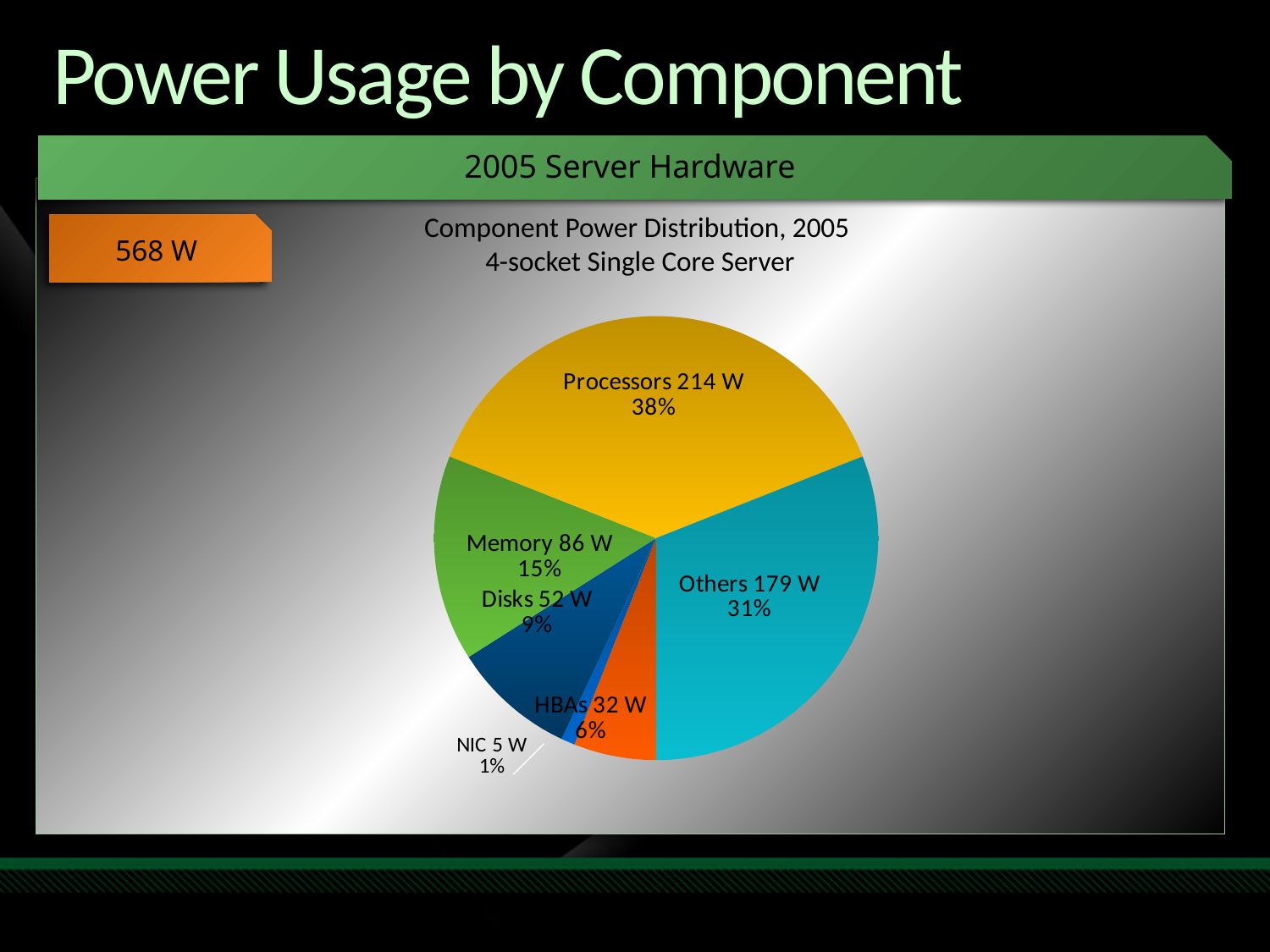
Which component uses the least power? NIC How many slices does the pie chart have? 6 What kind of chart is shown on the slide? pie chart What is the chart's title? Component Power Distribution, 2005 4-socket Single Core Server What share of the pie do Disks account for? 9% What share of the pie do HBAs account for? 6% Which component uses the most power? Processors Which uses more power, Memory or Disks? Memory What is the power usage of Processors? 214 W What is the power usage of Memory? 86 W What is the difference in power usage between Processors and Others? 35 W What is the power usage of Others? 179 W